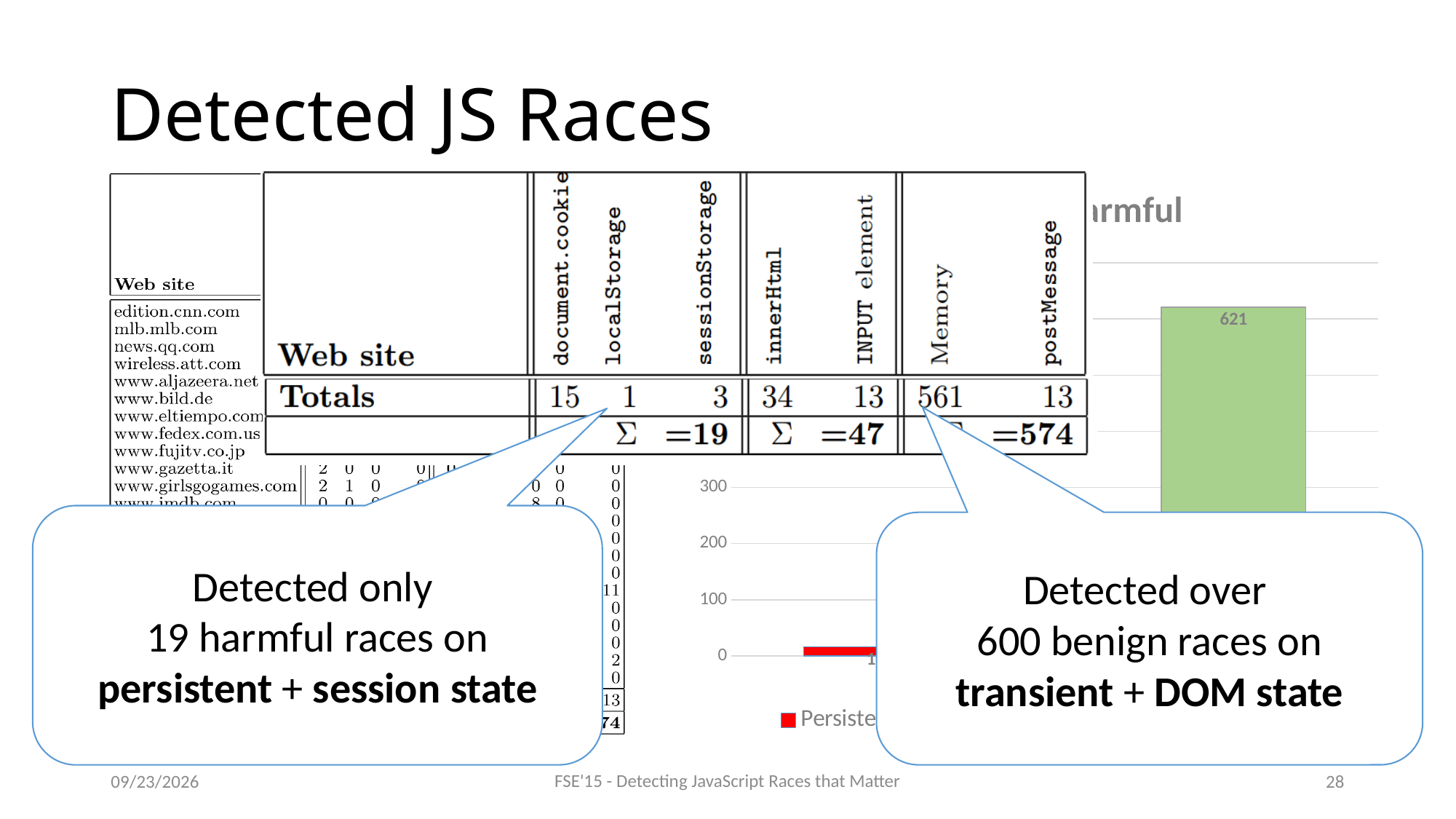
Is the value of the red bar greater or less than 100? less What value is printed on the green bar of the chart? 621 Which bar is taller in the chart, the green bar or the red bar? the green bar Is the value of the green bar greater or less than 300? greater What colour is the tallest bar in the chart? green What kind of chart is shown on the right side of the slide? bar chart